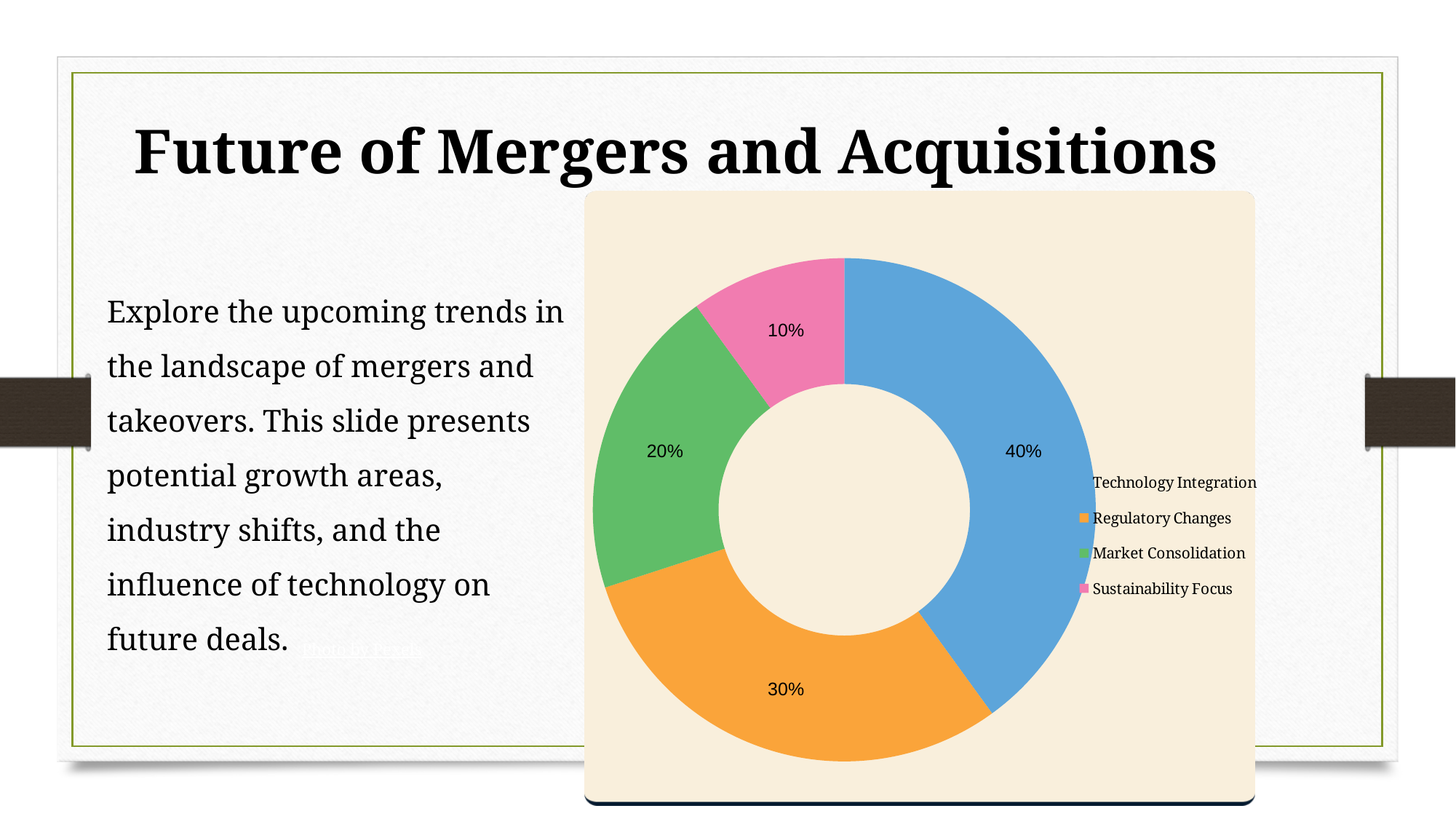
What is the difference in percentage points between Technology Integration and Market Consolidation? 20 What share of the doughnut chart does Sustainability Focus represent? 10% How many categories are shown in the chart? 4 Which is larger, the share for Regulatory Changes or the share for Sustainability Focus? Regulatory Changes Which category has the largest share in the chart? Technology Integration Which category has the smallest share in the chart? Sustainability Focus What share of the doughnut chart does Technology Integration represent? 40% What share of the doughnut chart does Market Consolidation represent? 20% What share of the doughnut chart does Regulatory Changes represent? 30% What kind of chart is shown on the slide? Doughnut chart What colour is the Market Consolidation slice? Green What is the combined share of Regulatory Changes and Sustainability Focus? 40%